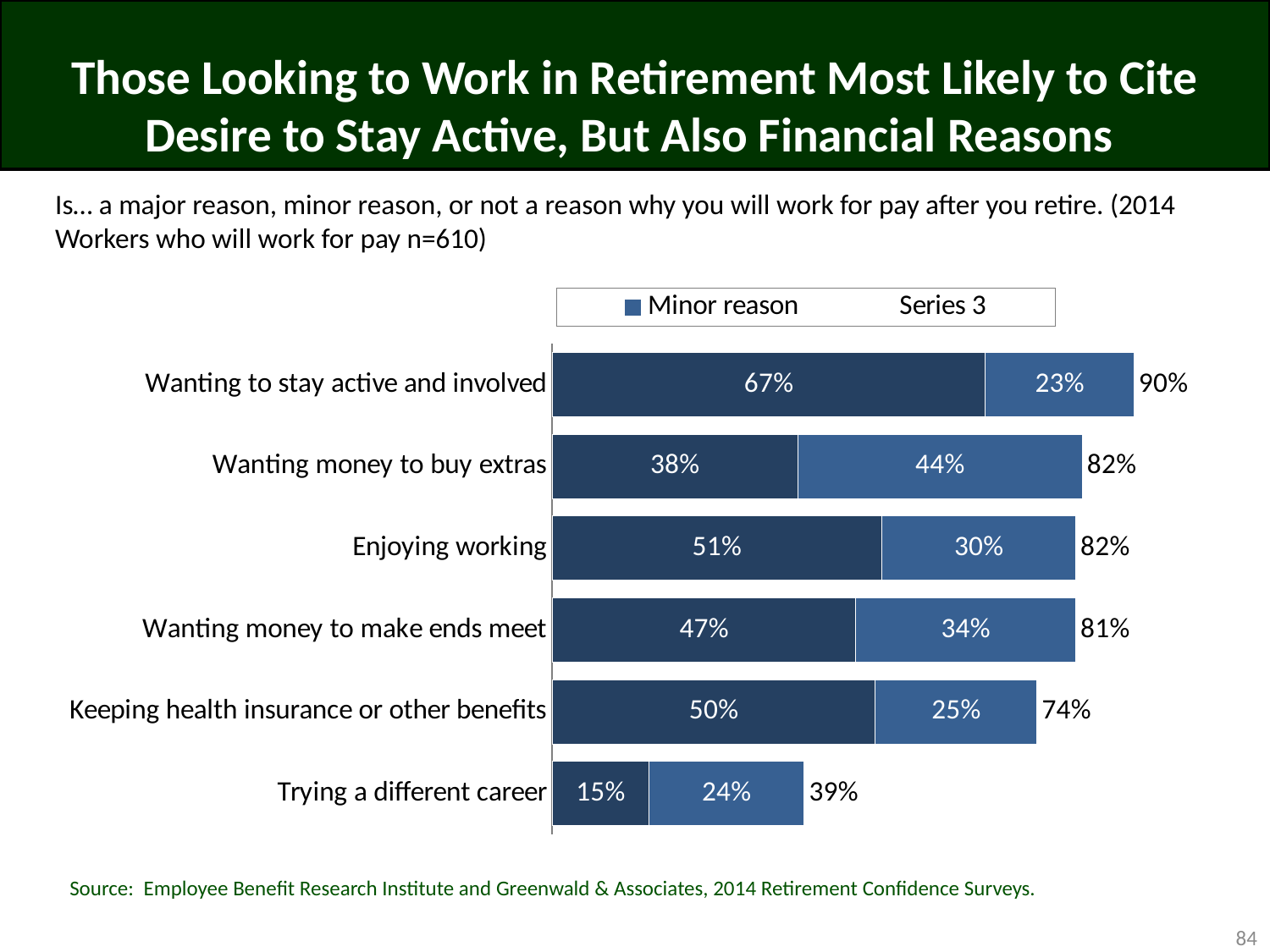
Which reason has the lowest total percentage? Trying a different career What is the difference between the total for "Wanting to stay active and involved" and the total for "Trying a different career"? 51 percentage points What is the total of the stacked bar for "Enjoying working"? 82% What is the value of the lighter blue segment for "Wanting money to buy extras"? 44% What kind of chart is shown on the slide? Stacked bar chart Which reason has the largest lighter blue segment? Wanting money to buy extras Which reason has the highest total percentage? Wanting to stay active and involved What total percentage is shown at the end of the bar for "Keeping health insurance or other benefits"? 74% What two entries does the legend list? Minor reason and Series 3 What is the value of the dark blue segment for "Wanting to stay active and involved"? 67% Which has a larger dark blue segment: "Enjoying working" or "Wanting money to make ends meet"? Enjoying working How many reasons (categories) are listed on the chart? 6